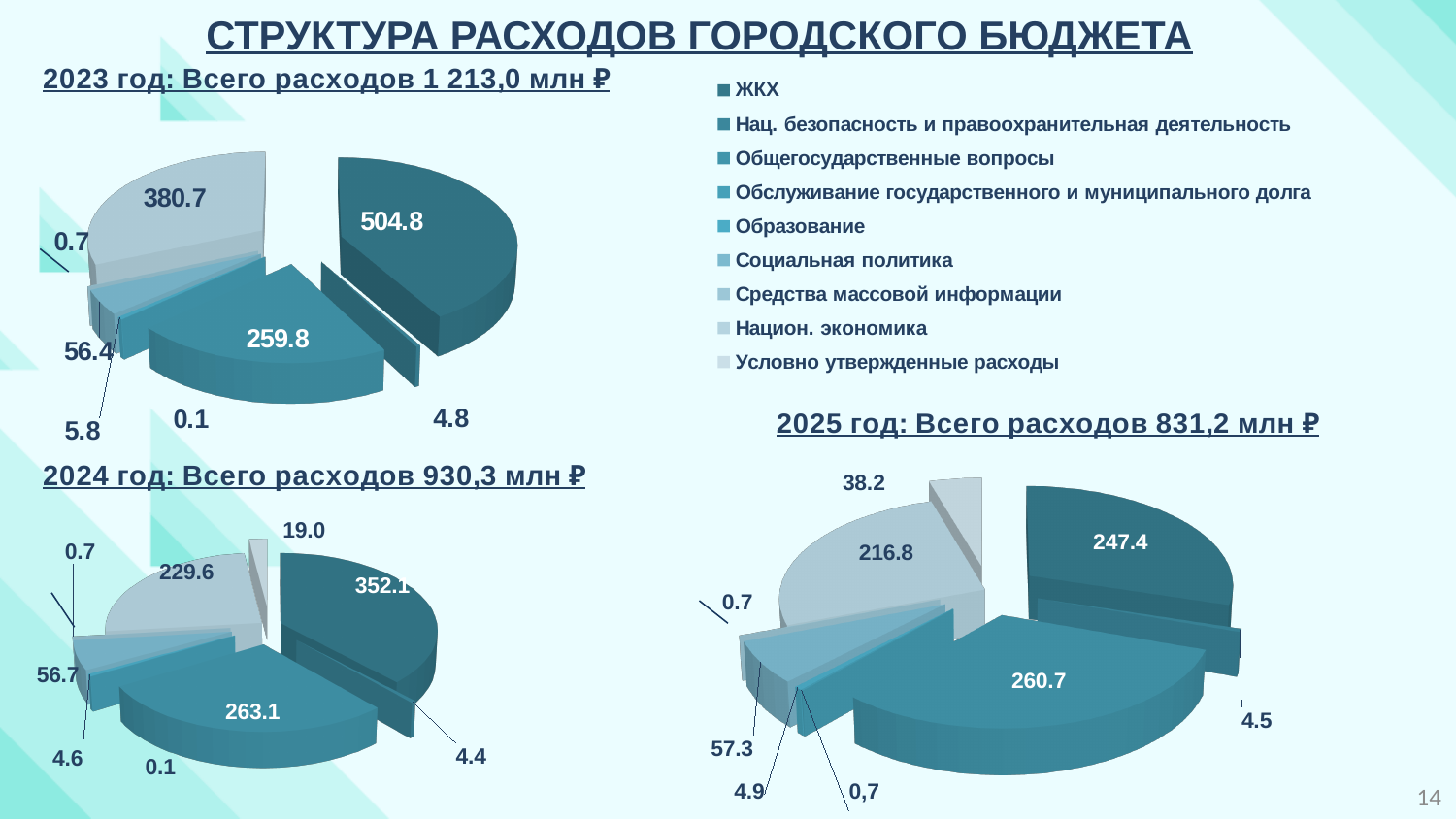
What type of chart is used for the 2023, 2024 and 2025 data on this slide? Pie chart According to the slide, what is the total expenditure for 2024? 930,3 млн ₽ In the 2023 chart, what is the difference between the two largest slices, 504.8 and 380.7? 124.1 In the 2024 chart, which is larger: the slice labeled 263.1 or the slice labeled 229.6? 263.1 In the 2025 chart, what is the difference between the slices labeled 260.7 and 247.4? 13.3 According to the slide, what is the total expenditure for 2025? 831,2 млн ₽ What is the first entry in the legend? ЖКХ In the 2024 chart, what is the smallest labeled value? 0.1 According to the slide, what is the total expenditure for 2023? 1 213,0 млн ₽ In the 2025 chart, what is the value of the largest slice? 260.7 How many categories does the shared legend list? 9 In the 2023 chart, what is the value of the largest slice? 504.8